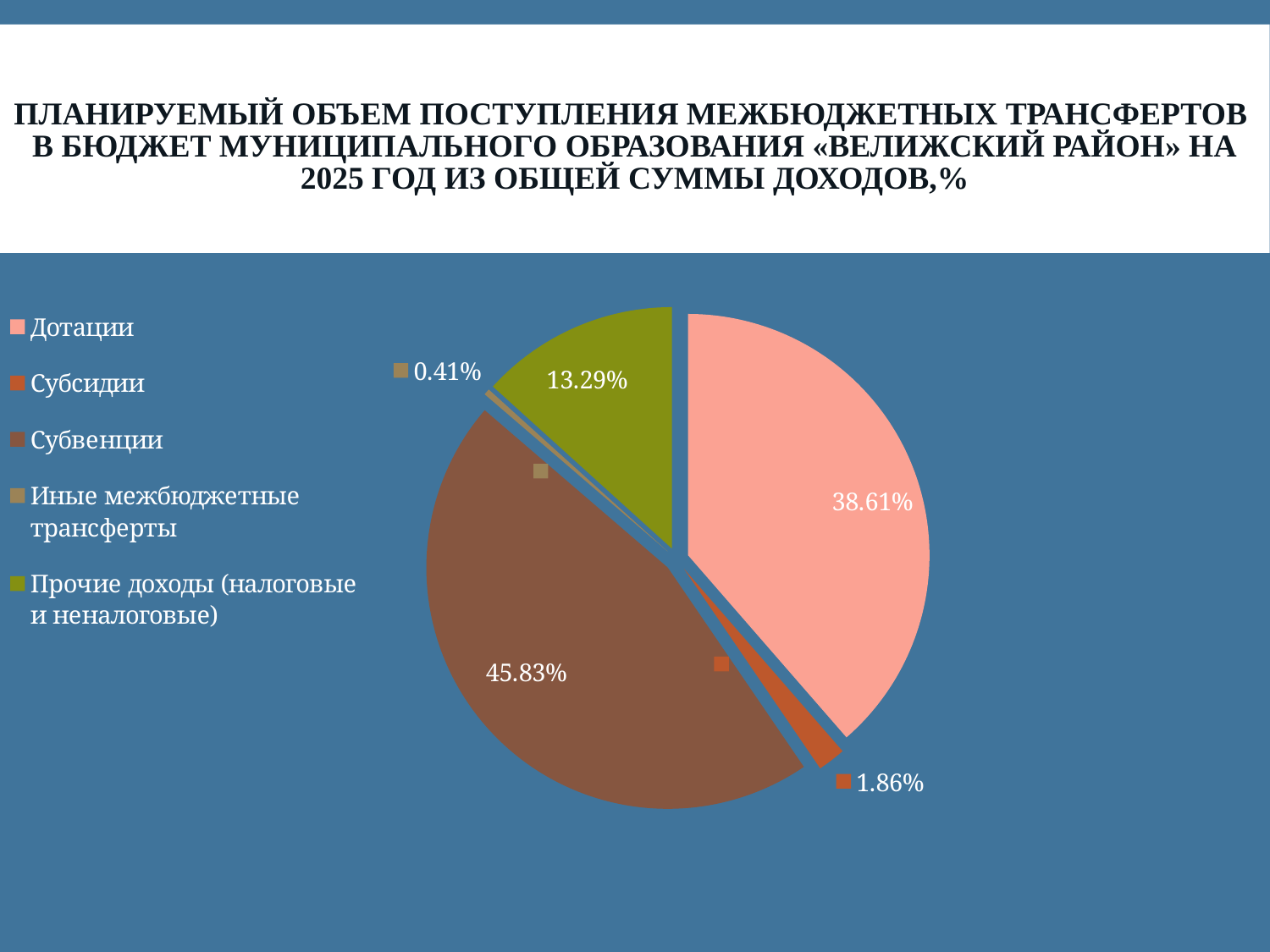
What is the value for Прочие доходы (налоговые и неналоговые)? 13.29% What is the value for Дотации? 38.61% Which is larger, the value for Дотации or the value for Прочие доходы (налоговые и неналоговые)? Дотации Which category has the largest share of the pie? Субвенции What is the difference between the values for Субвенции and Дотации? 7.22% How many categories does the pie chart have? 5 What is the value for Субсидии? 1.86% What is the value for Иные межбюджетные трансферты? 0.41% Which category has the smallest share of the pie? Иные межбюджетные трансферты What is the value for Субвенции? 45.83% What type of chart is shown on the slide? Pie chart What colour is the slice for Прочие доходы (налоговые и неналоговые)? Green